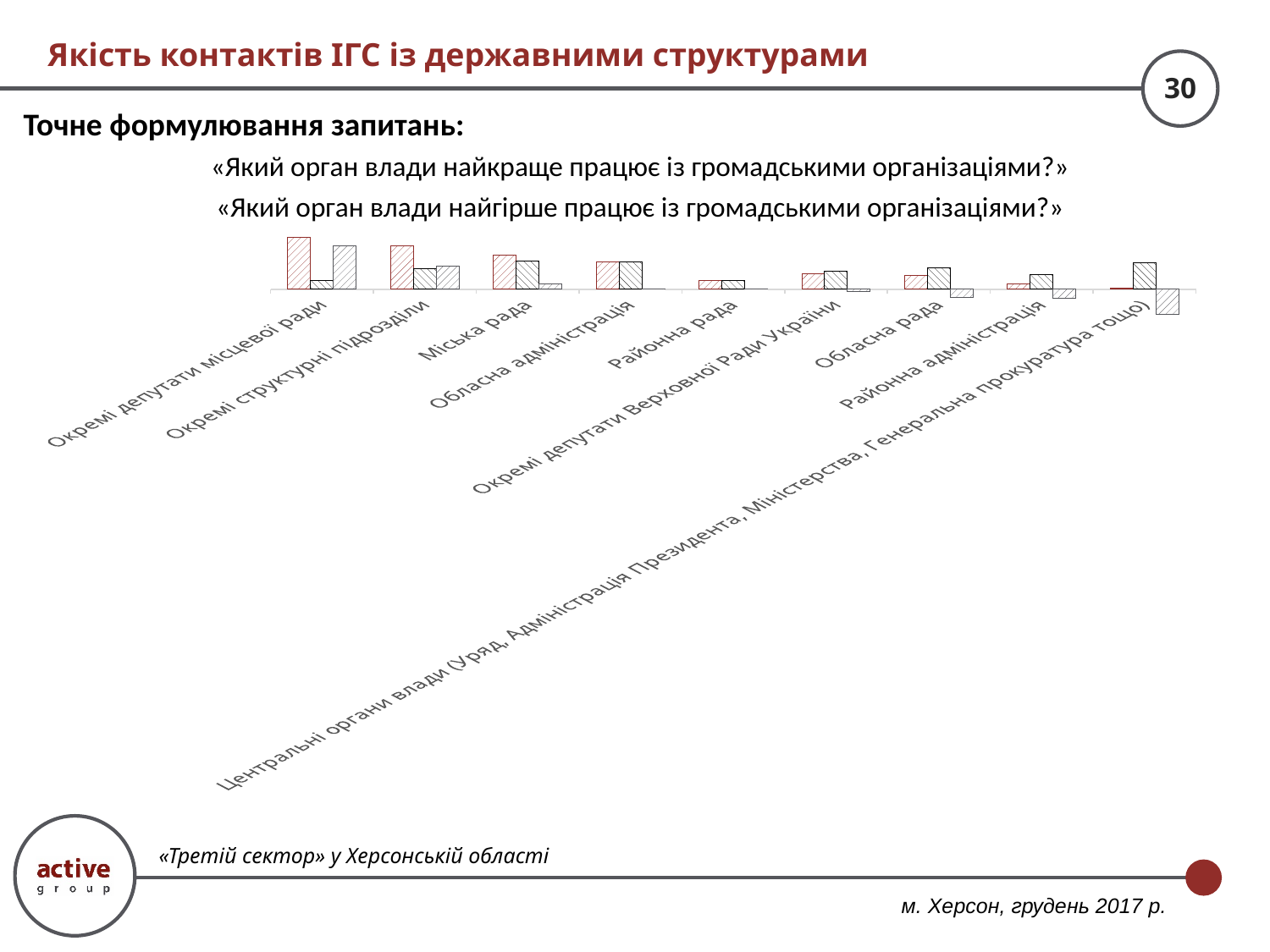
What kind of chart is shown on the slide? bar chart Is the red hatched bar for Окремі структурні підрозділи taller or shorter than the red hatched bar for Обласна рада? taller What is the label of the first category on the left of the x axis? Окремі депутати місцевої ради How many categories are shown along the x axis of the chart? 9 Is the red hatched bar for Окремі депутати місцевої ради taller or shorter than the red hatched bar for Районна рада? taller Which category has the tallest red hatched bar in the chart? Окремі депутати місцевої ради Which category has the shortest red hatched bar among Окремі депутати місцевої ради, Міська рада and Районна рада? Районна рада